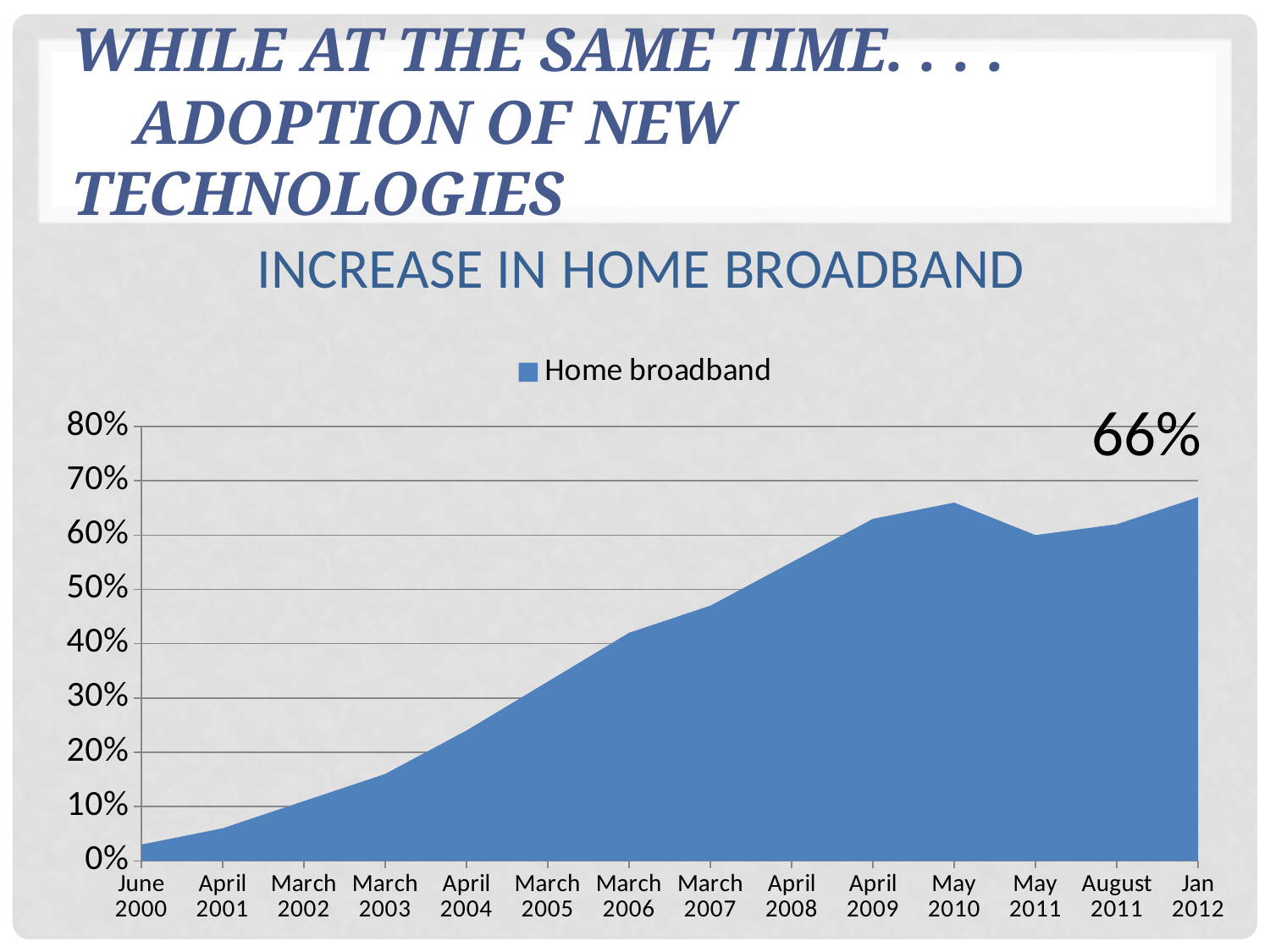
What is the title of the chart? INCREASE IN HOME BROADBAND Is the value for June 2000 greater or less than 10%? less Is the value for March 2003 greater or less than 20%? less How many time points are shown on the x axis? 14 What kind of chart is shown on the slide? Area chart Which time point has the lowest Home broadband value? June 2000 What series name is shown in the legend? Home broadband Do the Home broadband values generally rise or fall from June 2000 to Jan 2012? Rise Is the value for March 2006 greater or less than 40%? greater How many series does the legend list? 1 Which is larger, the value for March 2006 or the value for March 2003? March 2006